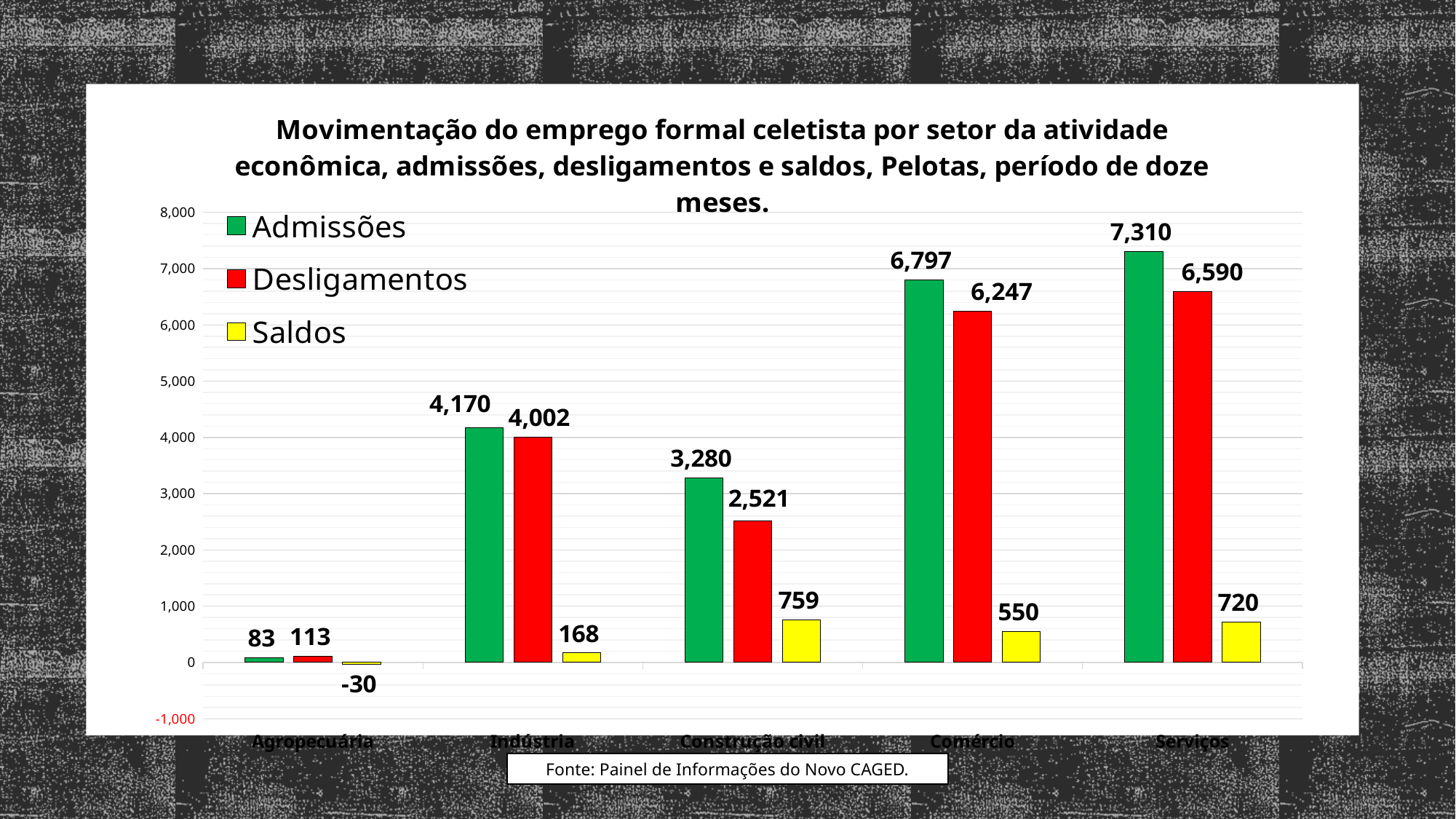
How many series does the legend list? 3 Which sector has the lowest Desligamentos value? Agropecuária What is the Desligamentos value for Indústria? 4,002 Which sector has the highest Admissões value? Serviços What kind of chart is shown on the slide? bar chart How many sectors are shown on the x axis? 5 What is the difference between Admissões and Desligamentos for Construção civil? 759 What is the Saldos value for Agropecuária? -30 What is the Admissões value for Serviços? 7,310 Is the Admissões value for Comércio greater or less than 6,000? greater Which is larger for Comércio: Admissões or Desligamentos? Admissões Which colour represents the Saldos series? yellow